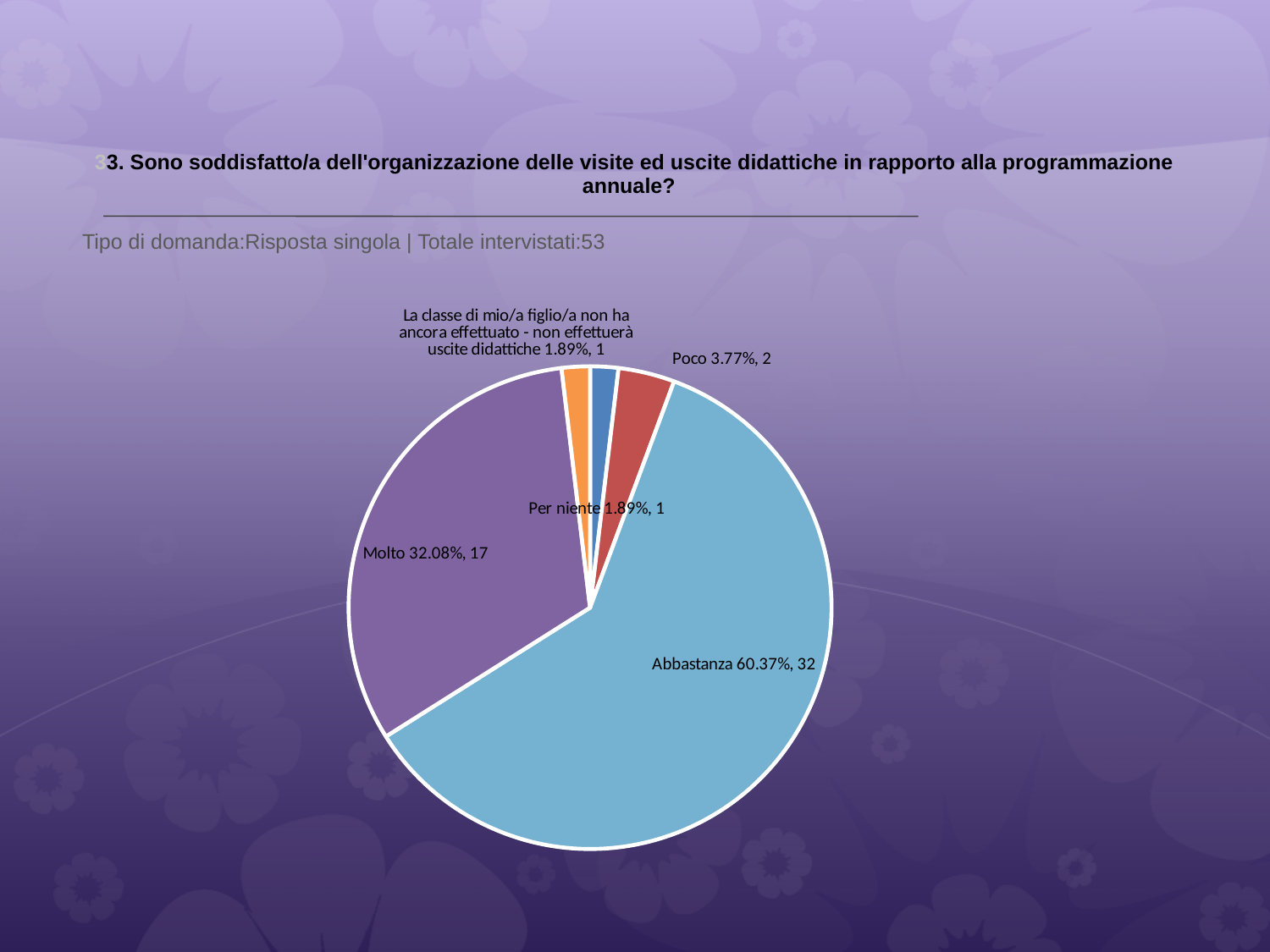
How many slices does the pie chart have? 5 What colour is the "Abbastanza" slice? light blue How many respondents answered "Molto"? 17 Which category has the largest slice of the pie? Abbastanza Which is larger, the "Poco" slice or the "Per niente" slice? Poco What is the difference in number of respondents between "Abbastanza" and "Molto"? 15 What percentage share does the "Abbastanza" slice have? 60.37% What kind of chart is shown on the slide? pie chart What is the total number of respondents stated on the slide? 53 What percentage share does the "Molto" slice have? 32.08% How many respondents answered "Poco"? 2 What percentage share does the "Per niente" slice have? 1.89%